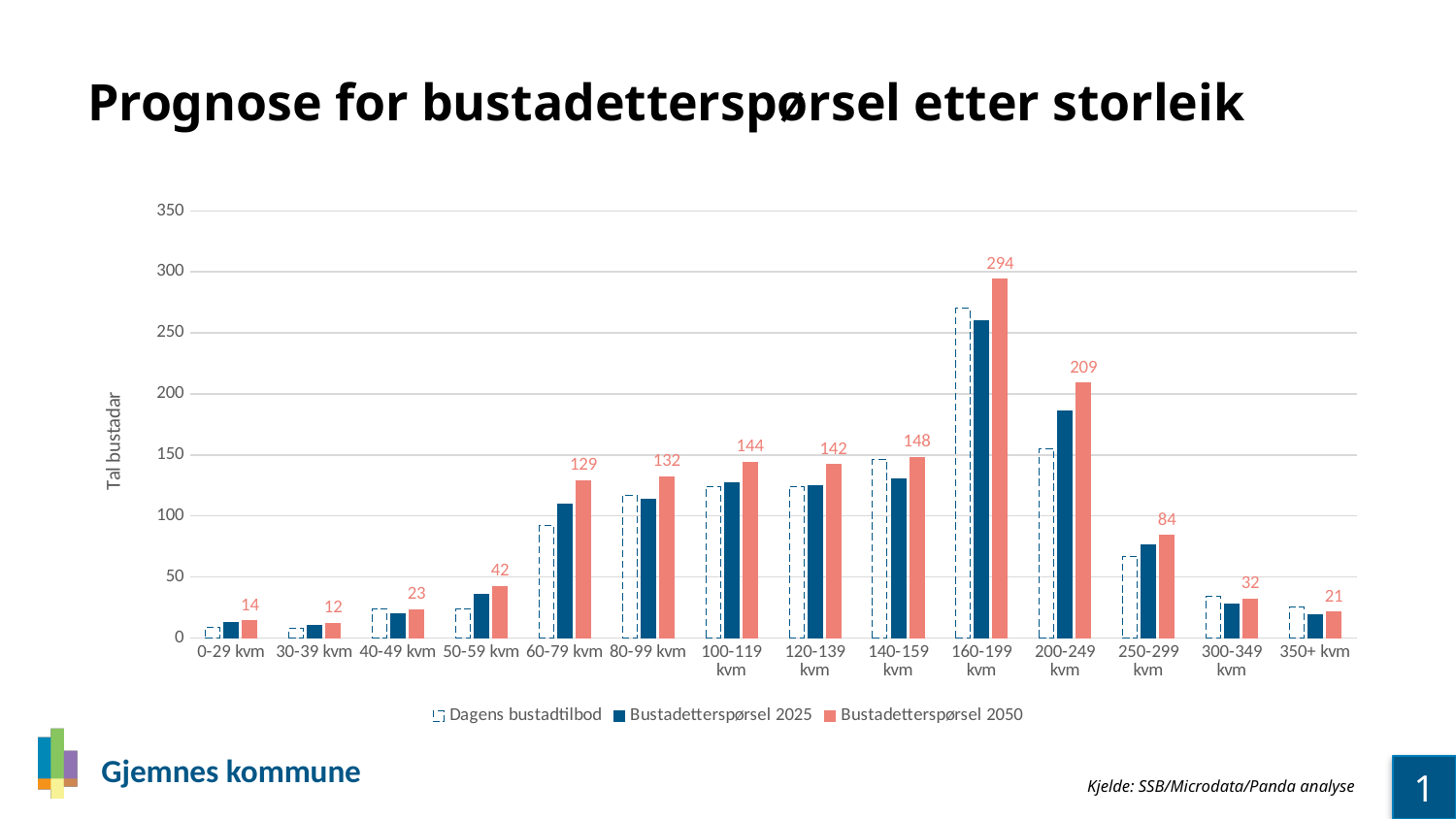
Is the Dagens bustadtilbod value for 60-79 kvm greater or less than 100? less What is the Bustadetterspørsel 2050 value for the 160-199 kvm category? 294 What is the Bustadetterspørsel 2050 value for the 50-59 kvm category? 42 How many series does the legend list? 3 What is the Bustadetterspørsel 2050 value for the 200-249 kvm category? 209 Which category has the highest Bustadetterspørsel 2050 value? 160-199 kvm Is the Bustadetterspørsel 2025 value for 160-199 kvm greater or less than 200? greater Which is larger, the Bustadetterspørsel 2050 value for 250-299 kvm or for 300-349 kvm? 250-299 kvm What type of chart is shown on the slide? Bar chart How many size categories are shown on the x axis? 14 What is the difference between the Bustadetterspørsel 2050 values for 160-199 kvm and 200-249 kvm? 85 Which category has the lowest Bustadetterspørsel 2050 value? 30-39 kvm